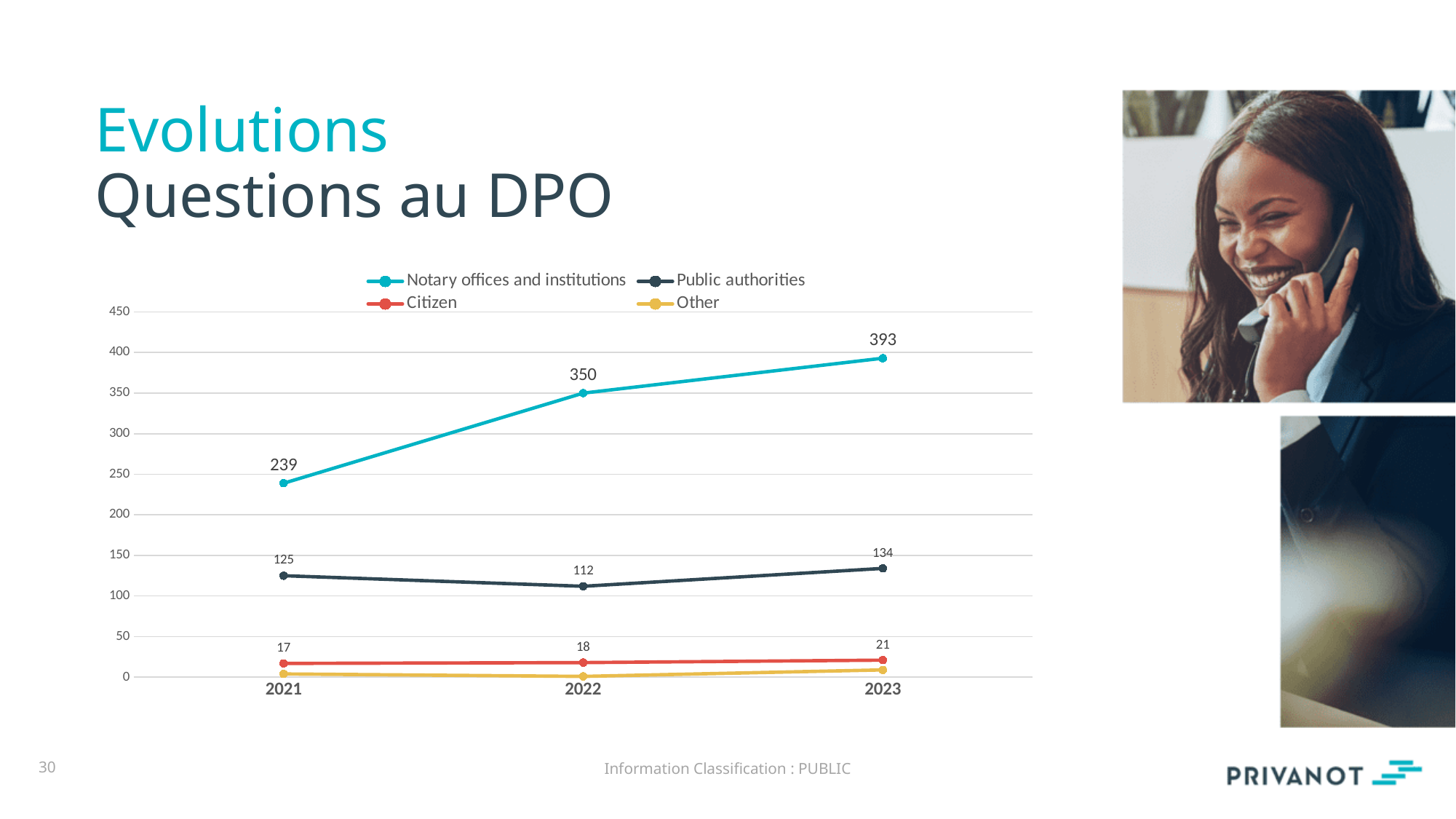
What is the value for Public authorities in 2021? 125 Which is larger in 2022: the value for Public authorities or the value for Citizen? Public authorities How many series does the legend list? 4 In which year is the value for Public authorities lowest? 2022 What is the difference between the Notary offices and institutions values for 2023 and 2021? 154 What is the value for Citizen in 2023? 21 Is the value for Other in 2023 greater or less than 50? less What is the value for Notary offices and institutions in 2022? 350 Do the values for Notary offices and institutions rise or fall from 2021 to 2023? rise What kind of chart is shown on the slide? line chart How many years are plotted on the x axis? 3 In which year is the value for Notary offices and institutions highest? 2023